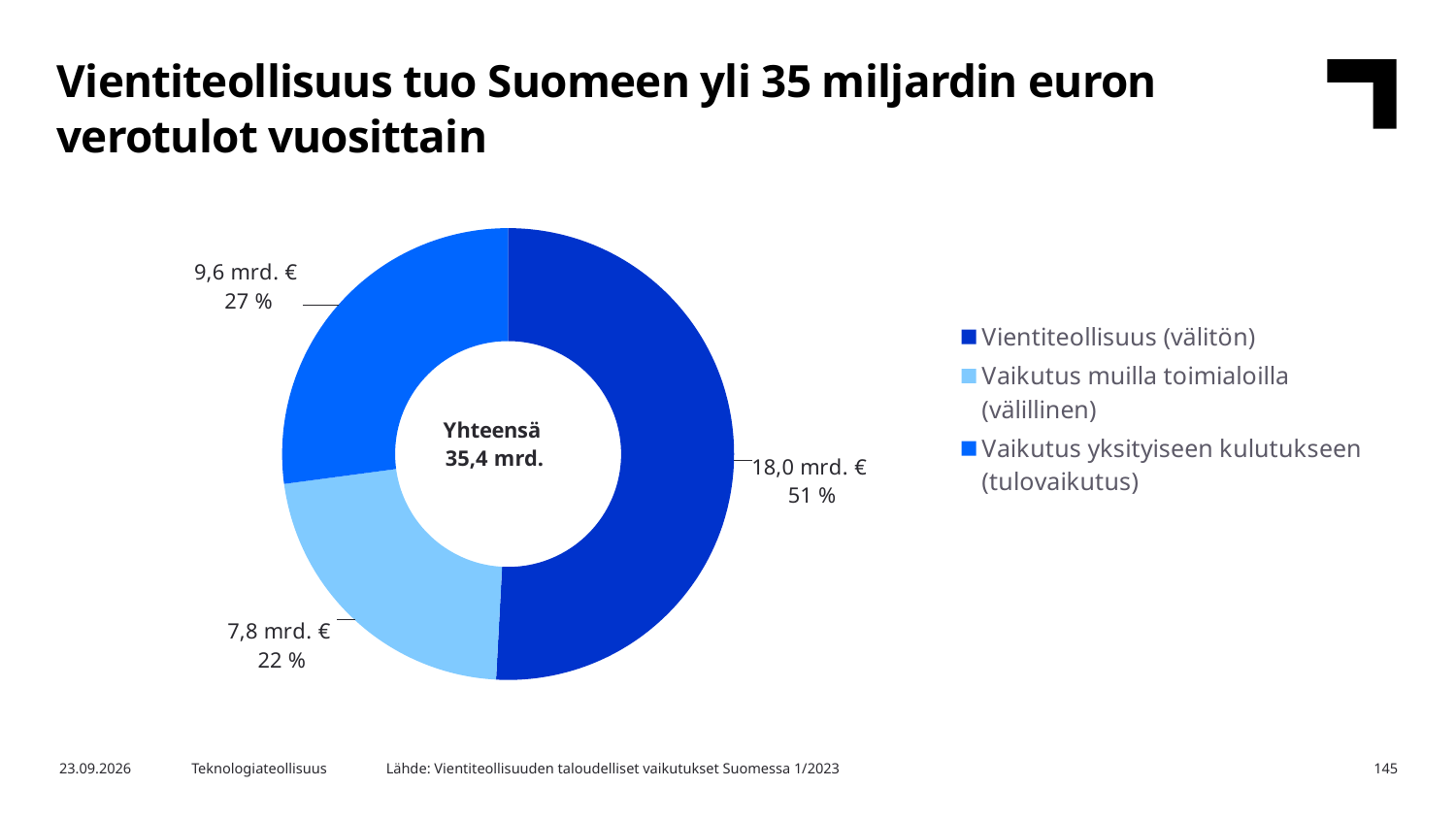
What kind of chart is shown on the slide? Donut (pie) chart What value is shown for Vaikutus yksityiseen kulutukseen (tulovaikutus)? 9,6 mrd. € What share of the total does Vientiteollisuus (välitön) represent? 51 % What share of the total does Vaikutus muilla toimialoilla (välillinen) represent? 22 % What value is shown for Vaikutus muilla toimialoilla (välillinen)? 7,8 mrd. € Which category has the largest slice? Vientiteollisuus (välitön) What share of the total does Vaikutus yksityiseen kulutukseen (tulovaikutus) represent? 27 % How many entries does the legend list? 3 What total is shown in the centre of the donut chart? 35,4 mrd. What is the difference between the values for Vientiteollisuus (välitön) and Vaikutus yksityiseen kulutukseen (tulovaikutus)? 8,4 mrd. € What value is shown for Vientiteollisuus (välitön)? 18,0 mrd. € Which category has the smallest slice? Vaikutus muilla toimialoilla (välillinen)